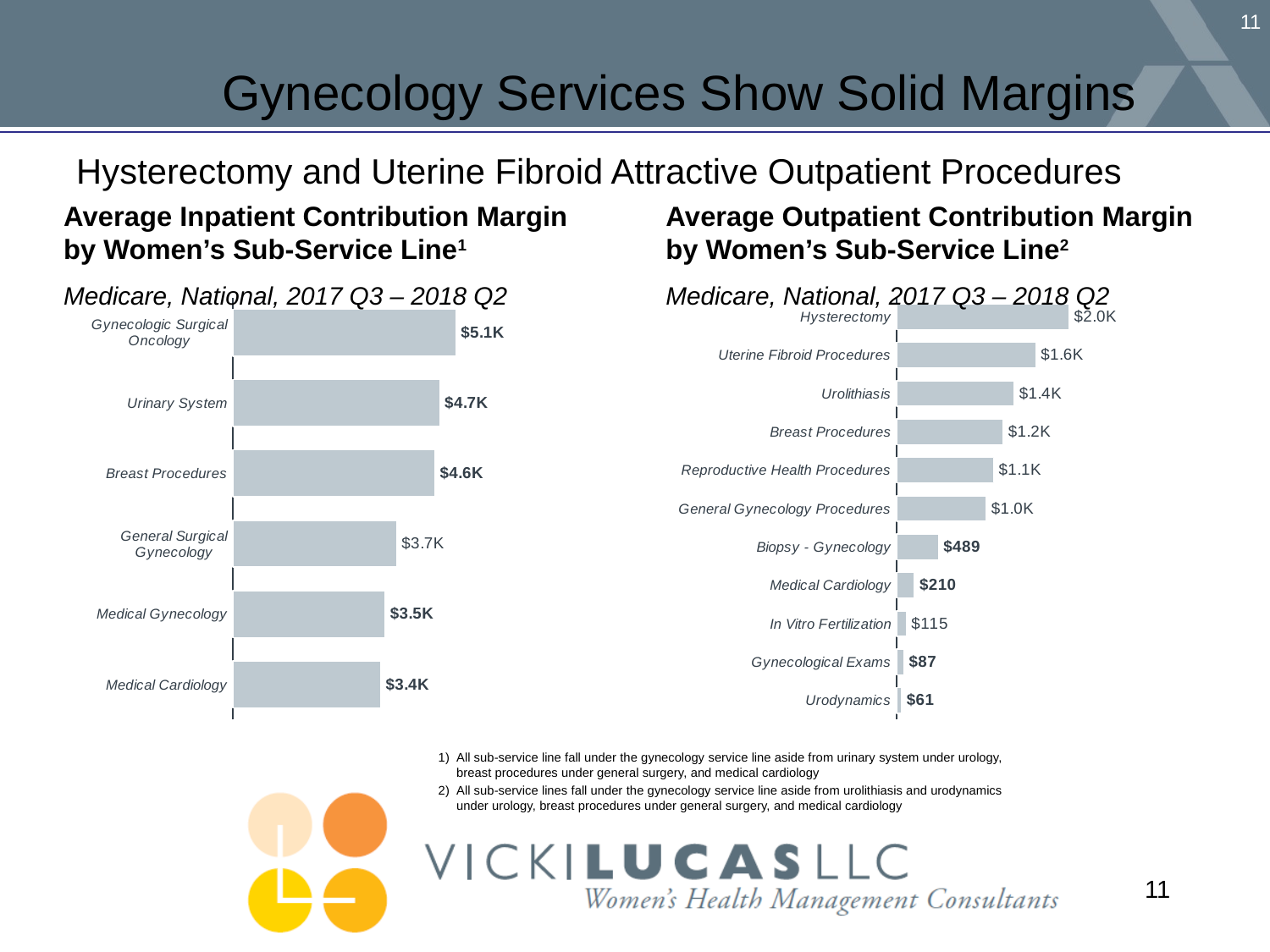
In the Average Outpatient Contribution Margin chart, which sub-service line has the highest value? Hysterectomy In the Average Inpatient Contribution Margin chart, what is the value for Urinary System? $4.7K In the Average Outpatient Contribution Margin chart, how many sub-service lines are shown? 11 In the Average Outpatient Contribution Margin chart, what is the value for Uterine Fibroid Procedures? $1.6K In the Average Outpatient Contribution Margin chart, what is the difference between Biopsy - Gynecology and Medical Cardiology? $279 In the Average Inpatient Contribution Margin chart, which sub-service line has the highest value? Gynecologic Surgical Oncology In the Average Inpatient Contribution Margin chart, how many sub-service lines are shown? 6 In the Average Outpatient Contribution Margin chart, which is larger, Biopsy - Gynecology or Medical Cardiology? Biopsy - Gynecology What type of chart is the Average Outpatient Contribution Margin chart? Bar chart In the Average Inpatient Contribution Margin chart, which sub-service line has the lowest value? Medical Cardiology In the Average Inpatient Contribution Margin chart, what is the difference between Gynecologic Surgical Oncology and Medical Cardiology? $1.7K In the Average Outpatient Contribution Margin chart, what is the value for Urodynamics? $61